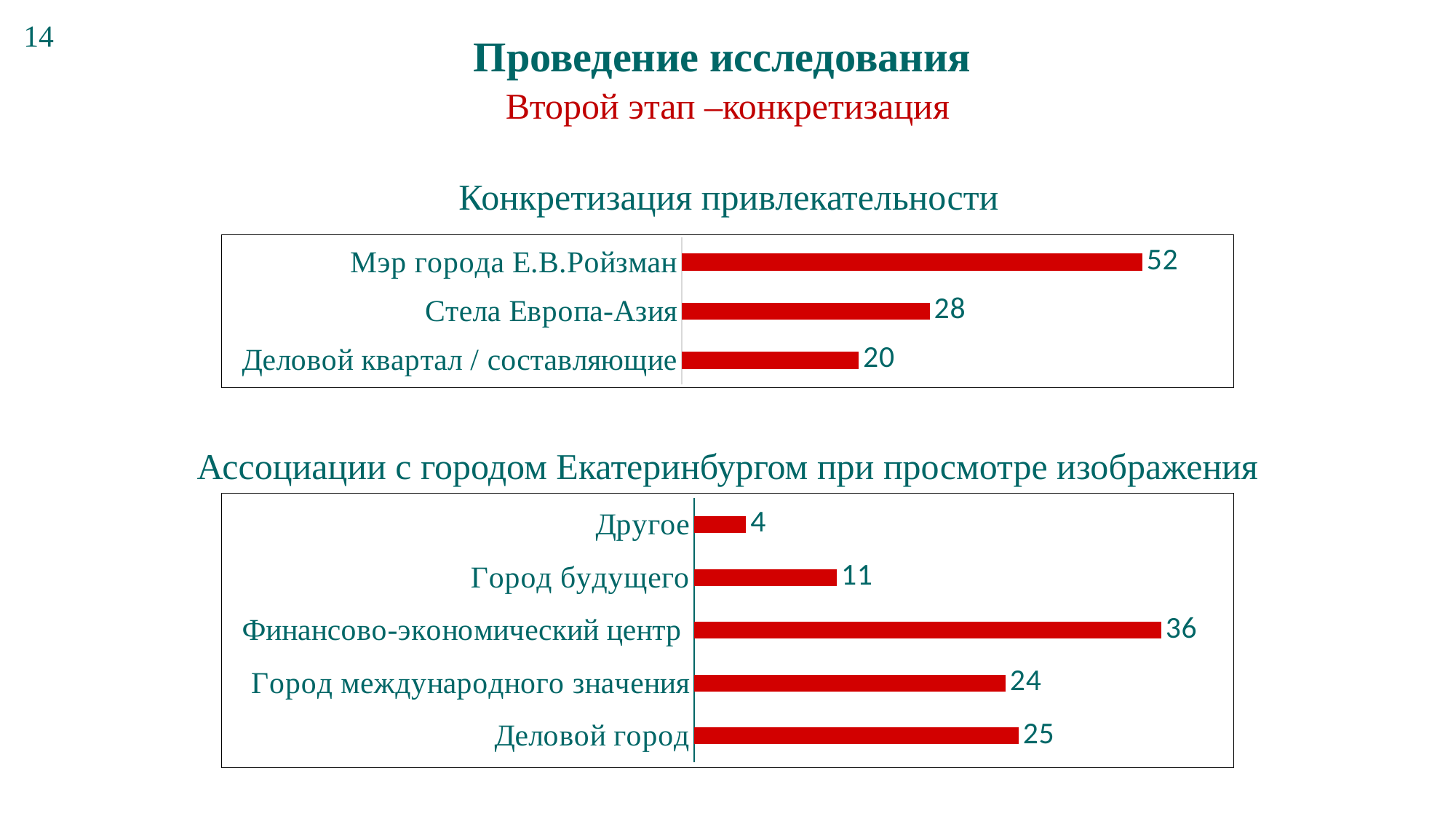
In the chart 'Конкретизация привлекательности', which category has the lowest value? Деловой квартал / составляющие In the chart 'Ассоциации с городом Екатеринбургом при просмотре изображения', how many categories are shown? 5 In the chart 'Конкретизация привлекательности', what is the value for 'Мэр города Е.В.Ройзман'? 52 In the chart 'Конкретизация привлекательности', what is the difference between the values for 'Мэр города Е.В.Ройзман' and 'Стела Европа-Азия'? 24 What type of chart is the chart 'Ассоциации с городом Екатеринбургом при просмотре изображения'? Bar chart In the chart 'Конкретизация привлекательности', what is the value for 'Стела Европа-Азия'? 28 In the chart 'Ассоциации с городом Екатеринбургом при просмотре изображения', what is the value for 'Город будущего'? 11 In the chart 'Ассоциации с городом Екатеринбургом при просмотре изображения', which category has the lowest value? Другое In the chart 'Ассоциации с городом Екатеринбургом при просмотре изображения', which category has the highest value? Финансово-экономический центр In the chart 'Конкретизация привлекательности', how many categories are shown? 3 In the chart 'Ассоциации с городом Екатеринбургом при просмотре изображения', what is the value for 'Финансово-экономический центр'? 36 In the chart 'Ассоциации с городом Екатеринбургом при просмотре изображения', which is larger: the value for 'Деловой город' or for 'Город международного значения'? Деловой город